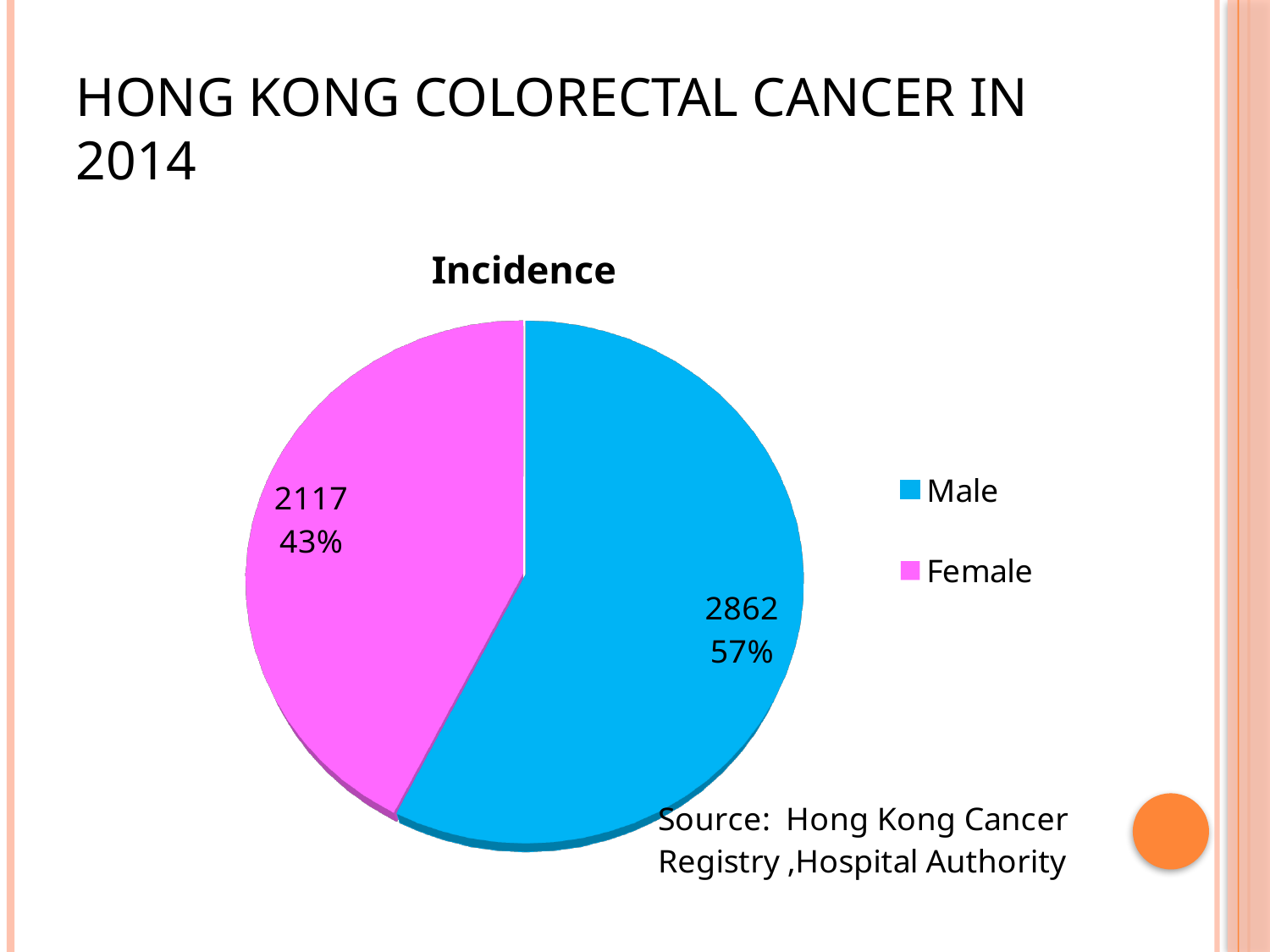
What percentage share of the pie does the Female slice represent? 43% What type of chart is shown on the slide? Pie chart Which category has the largest slice of the pie? Male What is the title of the chart? Incidence What is the incidence value for Female? 2117 What is the difference between the Male and Female incidence values? 745 Which is larger, the Male value or the Female value? Male What is the incidence value for Male? 2862 What percentage share of the pie does the Male slice represent? 57% Which category has the smallest slice of the pie? Female How many categories does the pie chart show? 2 What colour is the Female slice? Magenta (pink)